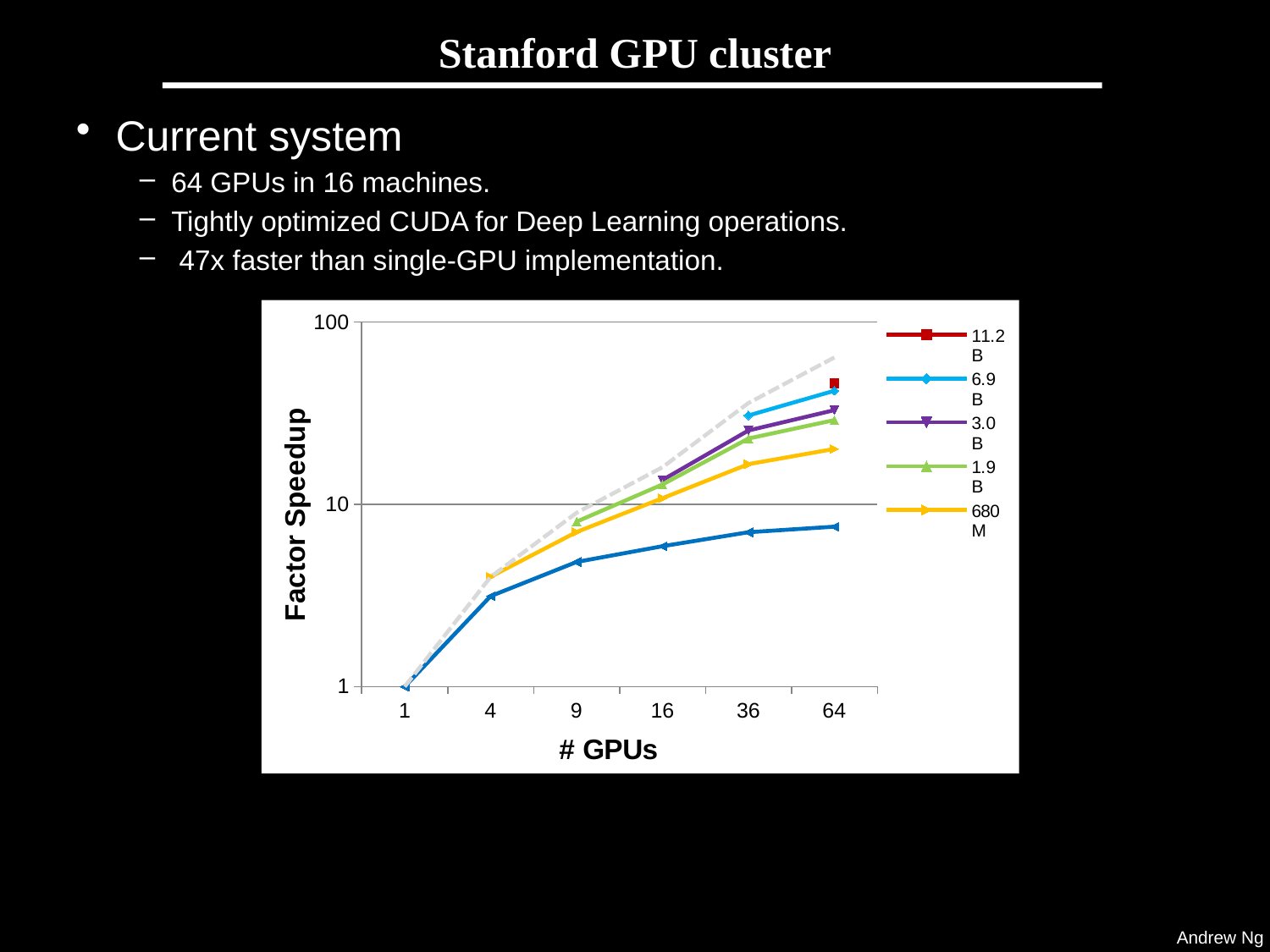
Is the Factor Speedup for the 6.9 B series at 64 GPUs greater or less than 100? less At 64 GPUs, which series has the higher Factor Speedup, 6.9 B or 680 M? 6.9 B Is the Factor Speedup for the 680 M series at 4 GPUs greater or less than 10? less Among the series listed in the legend, which has the highest Factor Speedup at 64 GPUs? 11.2 B Is the Factor Speedup for the 1.9 B series at 36 GPUs greater or less than 10? greater How many # GPUs values are marked on the x axis of the chart? 6 What is the label of the x axis of the chart? # GPUs What is the label of the y axis of the chart? Factor Speedup Does the Factor Speedup for the 680 M series rise or fall as the number of GPUs increases? rise How many series does the chart legend list? 5 What kind of chart is shown on the slide? line chart